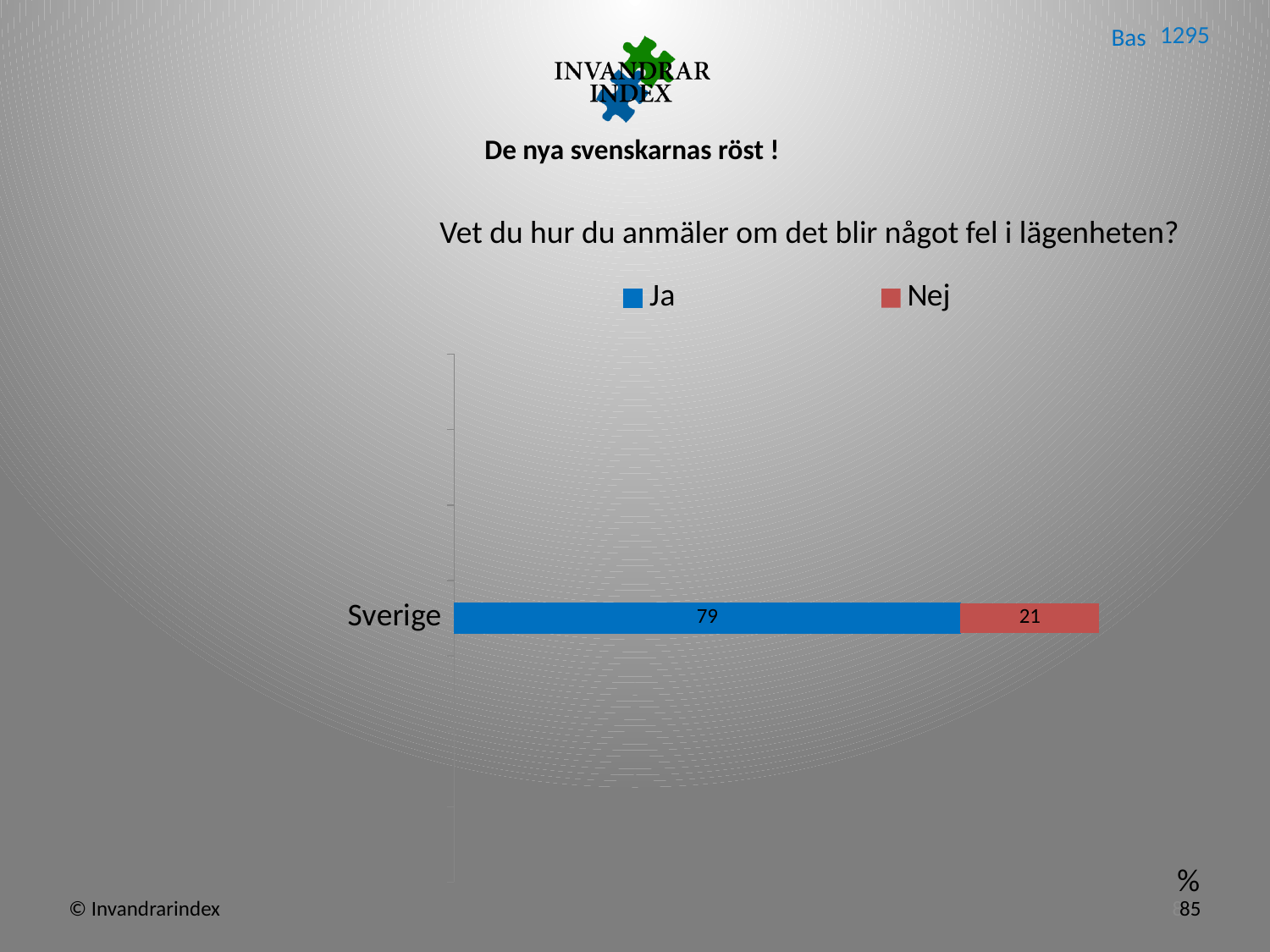
What is the name of the only category on the chart? Sverige How many categories are shown on the chart? 1 Which colour represents Nej in the chart? Red What is the value for Ja for Sverige? 79 Which series has the larger value for Sverige, Ja or Nej? Ja What is the difference between the Ja and Nej values for Sverige? 58 How many series does the legend list? 2 What is the total of the stacked bar for Sverige? 100 What is the value for Nej for Sverige? 21 What kind of chart is shown on the slide? Stacked bar chart What is the title of the chart? Vet du hur du anmäler om det blir något fel i lägenheten?